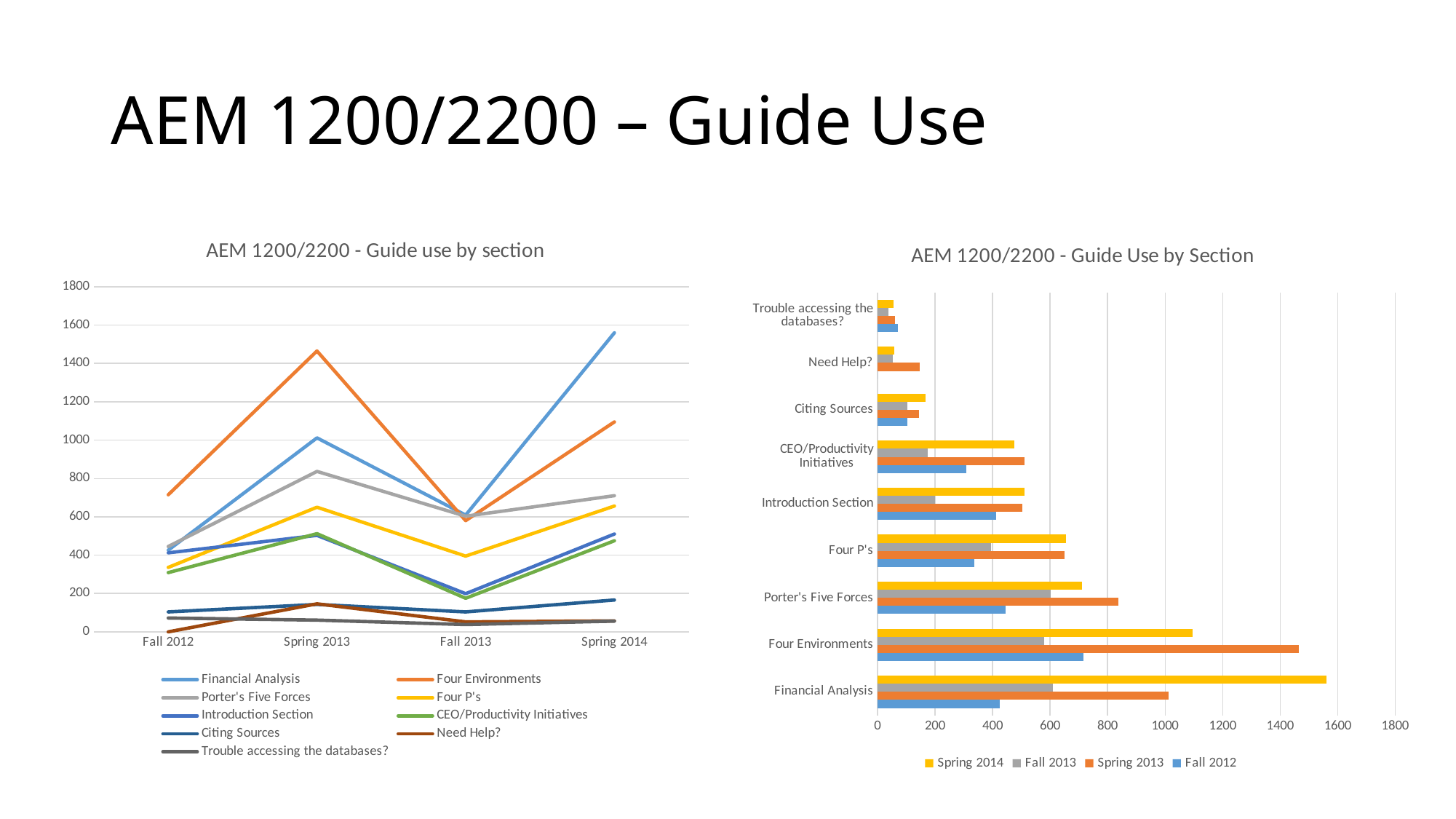
In the left line chart, which series has the highest value in Spring 2014? Financial Analysis In the left line chart, does the Four Environments line rise or fall from Fall 2012 to Spring 2013? rise In the right bar chart, how many series does the legend list? 4 In the left line chart, is the value for Financial Analysis in Spring 2014 greater or less than 1400? greater In the right bar chart, is the Spring 2013 value for Four Environments greater or less than 1400? greater In the left line chart, which series has the highest value in Spring 2013? Four Environments What type of chart is the left chart titled 'AEM 1200/2200 - Guide use by section'? line chart In the right bar chart, how many sections are listed on the vertical axis? 9 In the left line chart, how many series does the legend list? 9 In the right bar chart, which is larger for Porter's Five Forces: the Spring 2013 value or the Fall 2013 value? Spring 2013 What type of chart is the right chart titled 'AEM 1200/2200 - Guide Use by Section'? bar chart In the left line chart, how many time periods are shown on the x axis? 4